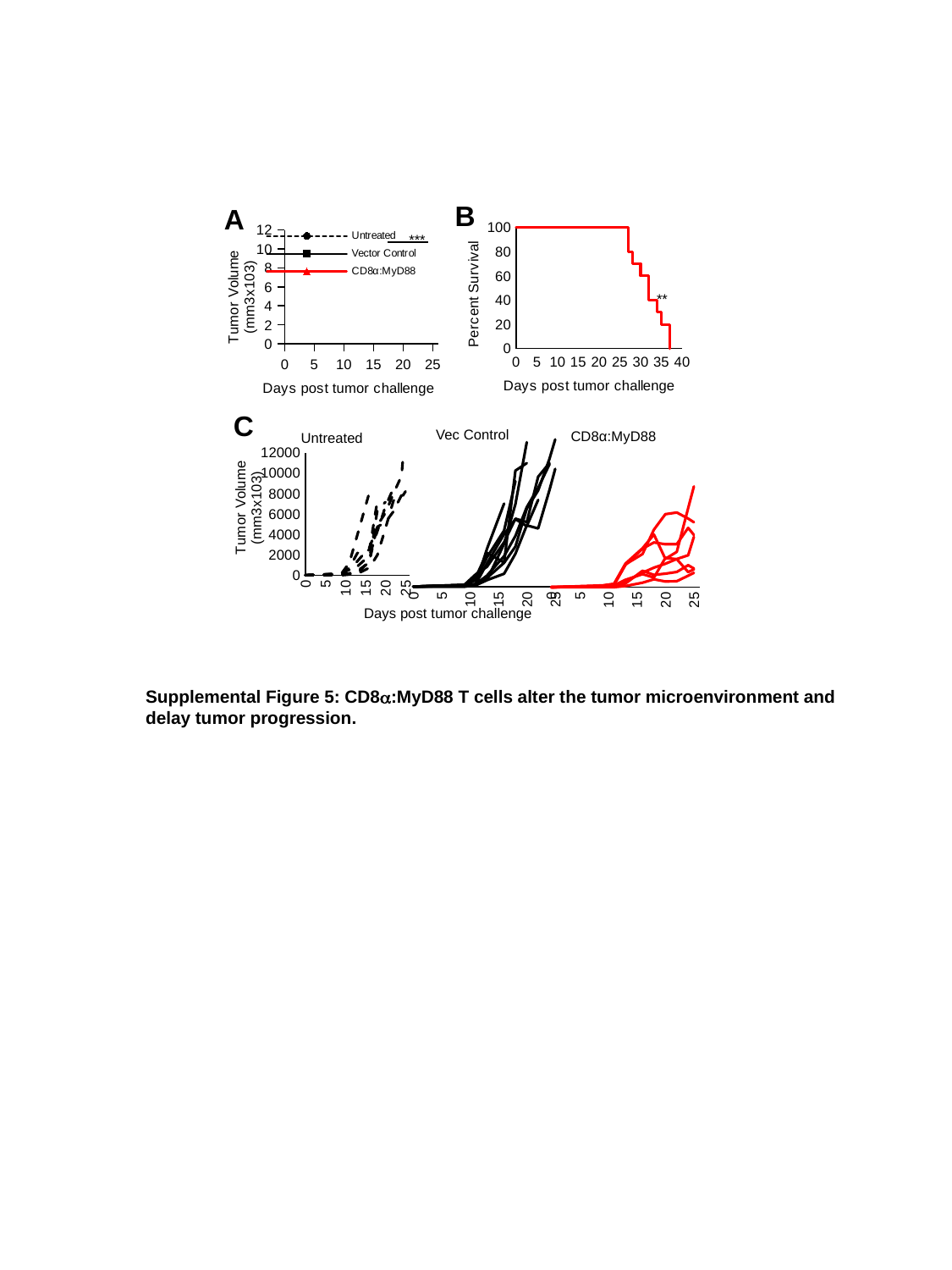
In panel B, does percent survival rise or fall as days post tumor challenge increase? fall In panel B, is the percent survival at day 20 greater or less than 80? greater In panel B, what is the label of the y axis? Percent Survival In panel C, how many treatment groups are plotted as separate sub-panels? 3 In panel A, how many series does the legend list? 3 In panel A, what is the label of the y axis? Tumor Volume (mm3x103) In panel B, what kind of chart is shown? line chart In panel C, does tumor volume rise or fall over days post tumor challenge in the Vec Control group? rise In panel C, what colour are the lines for the CD8α:MyD88 group? red In panel B, what is the percent survival at day 0? 100 In panel B, is the percent survival at day 35 greater or less than 40? less